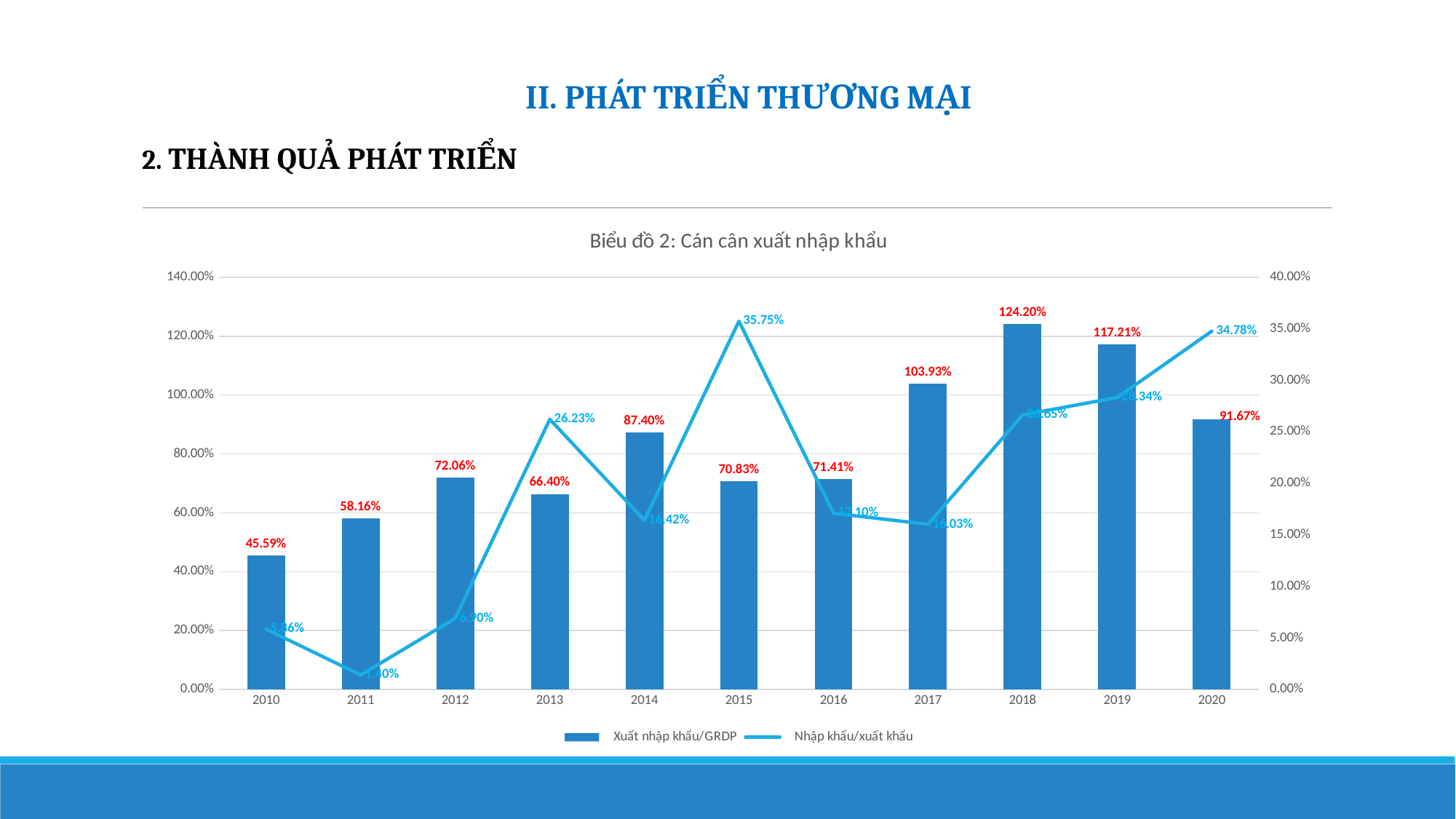
What is the value of Xuất nhập khẩu/GRDP for 2018? 124.20% How many years are shown on the x axis of the chart? 11 Which year has the larger Xuất nhập khẩu/GRDP value, 2013 or 2014? 2014 What is the value of Nhập khẩu/xuất khẩu for 2015? 35.75% What is the value of Nhập khẩu/xuất khẩu for 2020? 34.78% Is the Xuất nhập khẩu/GRDP value for 2020 greater or less than 80.00%? greater How many series does the legend list? 2 What is the difference between the Xuất nhập khẩu/GRDP values for 2018 and 2019? 6.99% Which year has the lowest Xuất nhập khẩu/GRDP bar? 2010 What is the difference between the Nhập khẩu/xuất khẩu values for 2013 and 2014? 9.81% Which year has the highest Xuất nhập khẩu/GRDP bar? 2018 What is the value of Xuất nhập khẩu/GRDP for 2010? 45.59%